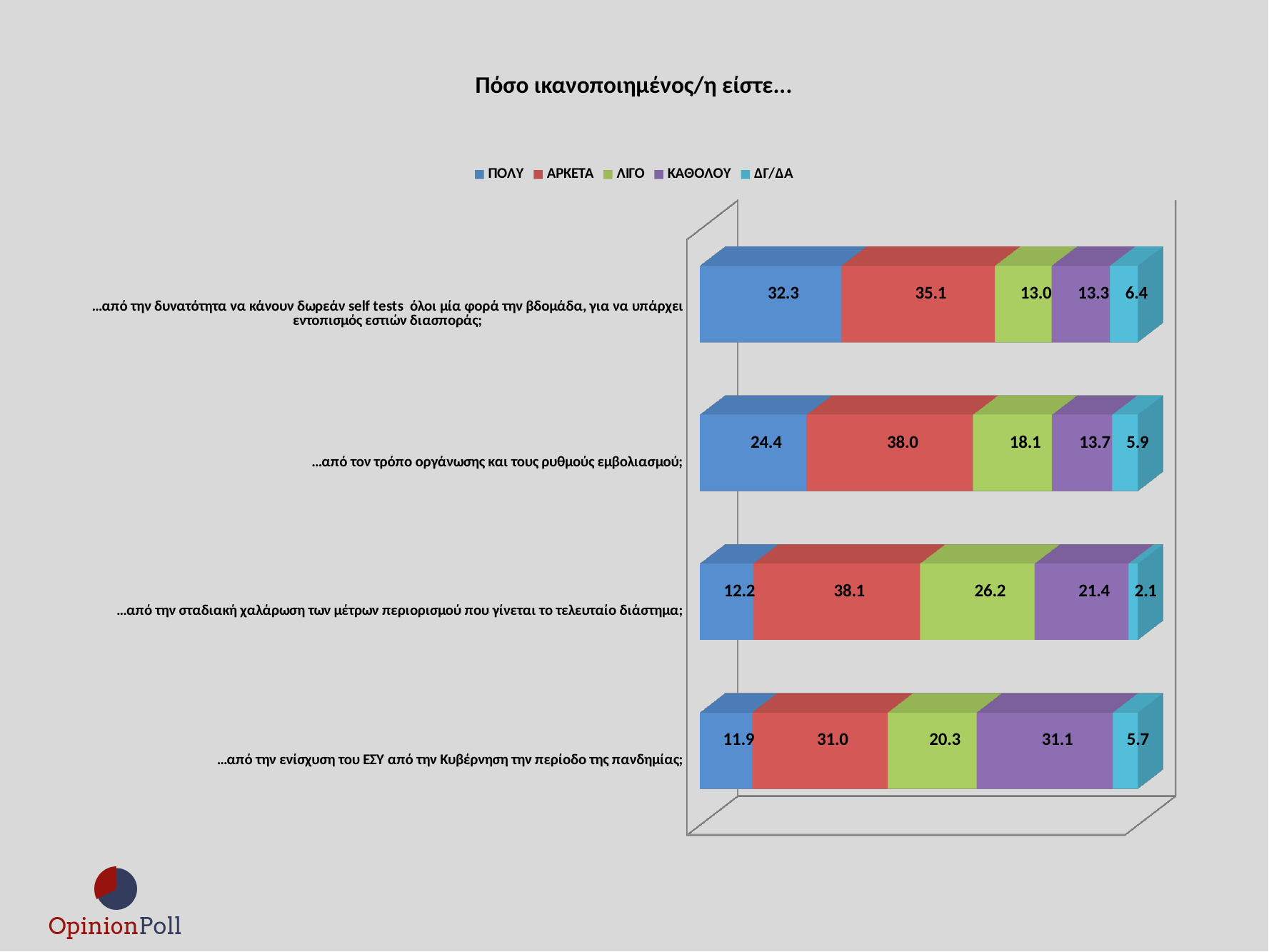
What is the ΠΟΛΥ value for the category about free self tests once a week (δωρεάν self tests)? 32.3 What is the difference between the ΛΙΓΟ value for the gradual relaxation of measures category and the ΛΙΓΟ value for the vaccination category? 8.1 How many categories (questions) are plotted on the chart? 4 Which category has the lowest ΔΓ/ΔΑ value? ...από την σταδιακή χαλάρωση των μέτρων περιορισμού που γίνεται το τελευταίο διάστημα; What is the ΚΑΘΟΛΟΥ value for the category about strengthening the ΕΣΥ by the government during the pandemic? 31.1 What type of chart is shown on the slide? Stacked bar chart What is the total of the stacked bar for the category about the gradual relaxation of restriction measures? 100.0 Which is larger: the ΚΑΘΟΛΟΥ value for the ΕΣΥ category or the ΚΑΘΟΛΟΥ value for the self tests category? The ΕΣΥ category (31.1) What is the ΔΓ/ΔΑ value for the category about the gradual relaxation of restriction measures? 2.1 What is the ΑΡΚΕΤΑ value for the category about the organisation and pace of vaccination (ρυθμούς εμβολιασμού)? 38.0 Which category has the highest ΠΟΛΥ value? ...από την δυνατότητα να κάνουν δωρεάν self tests όλοι μία φορά την βδομάδα, για να υπάρχει εντοπισμός εστιών διασποράς; How many series does the legend list? 5